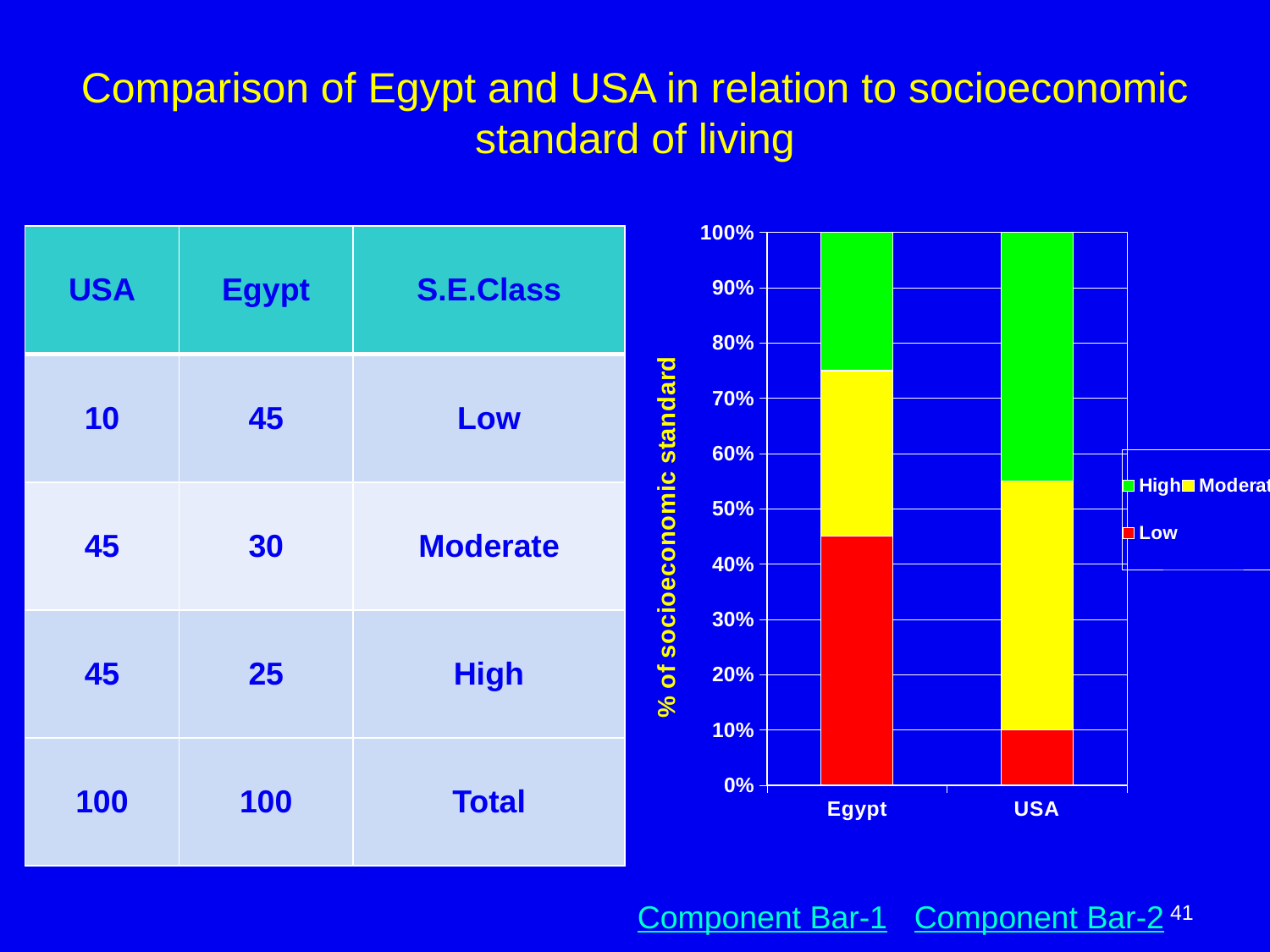
How many series does the chart legend list? 3 Is the Low segment for Egypt greater or less than 40%? greater According to the table, what is the difference between the Low values for Egypt and USA? 35 Is the Low segment for USA greater or less than 20%? less What is the total height of the stacked bar for Egypt? 100% What is the title of the chart's y axis? % of socioeconomic standard How many countries are plotted on the x axis of the chart? 2 What colour represents the Low class in the chart? red Which country has the larger Low segment in the chart, Egypt or USA? Egypt What kind of chart is shown on the slide? bar chart Which country has the larger High segment in the chart? USA According to the table, what is the Low value for USA? 10